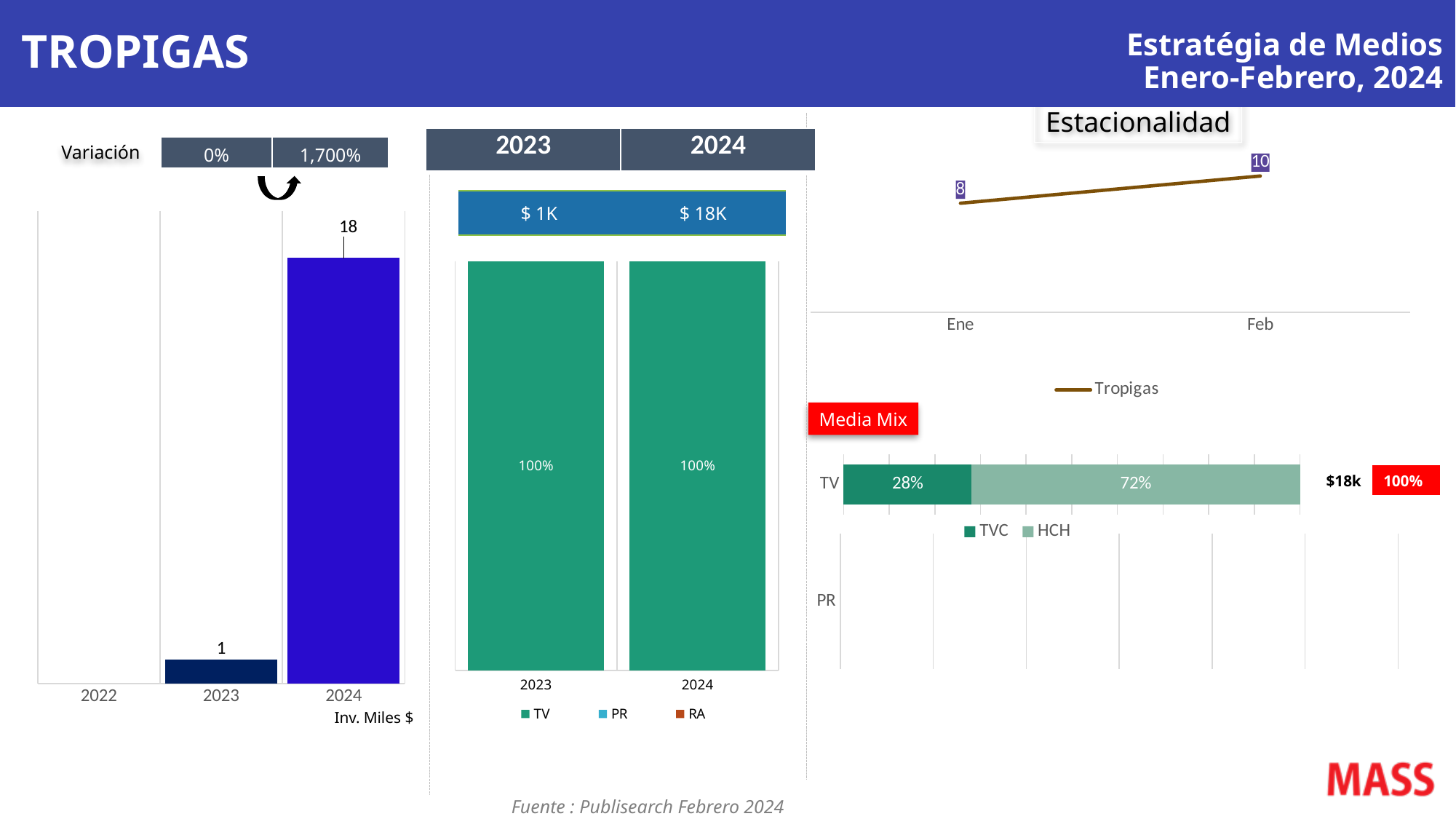
In the middle stacked bar chart, what share does TV have in 2024? 100% In the Media Mix chart, what percentage of TV is HCH? 72% In the Estacionalidad line chart, what is the value for Feb? 10 In the left bar chart (Inv. Miles $), which year has the highest value? 2024 In the left bar chart (Inv. Miles $), what is the value for 2023? 1 What kind of chart is the left chart labelled Inv. Miles $? Bar chart In the middle stacked bar chart (2023 vs 2024), how many series does the legend list? 3 In the Estacionalidad line chart, do the values rise or fall from Ene to Feb? Rise In the left bar chart (Inv. Miles $), what is the difference between the 2024 and 2023 values? 17 In the left bar chart (Inv. Miles $), how many year categories are shown on the x axis? 3 In the left bar chart (Inv. Miles $), what is the value for 2024? 18 In the Media Mix chart, which is larger for TV, TVC or HCH? HCH